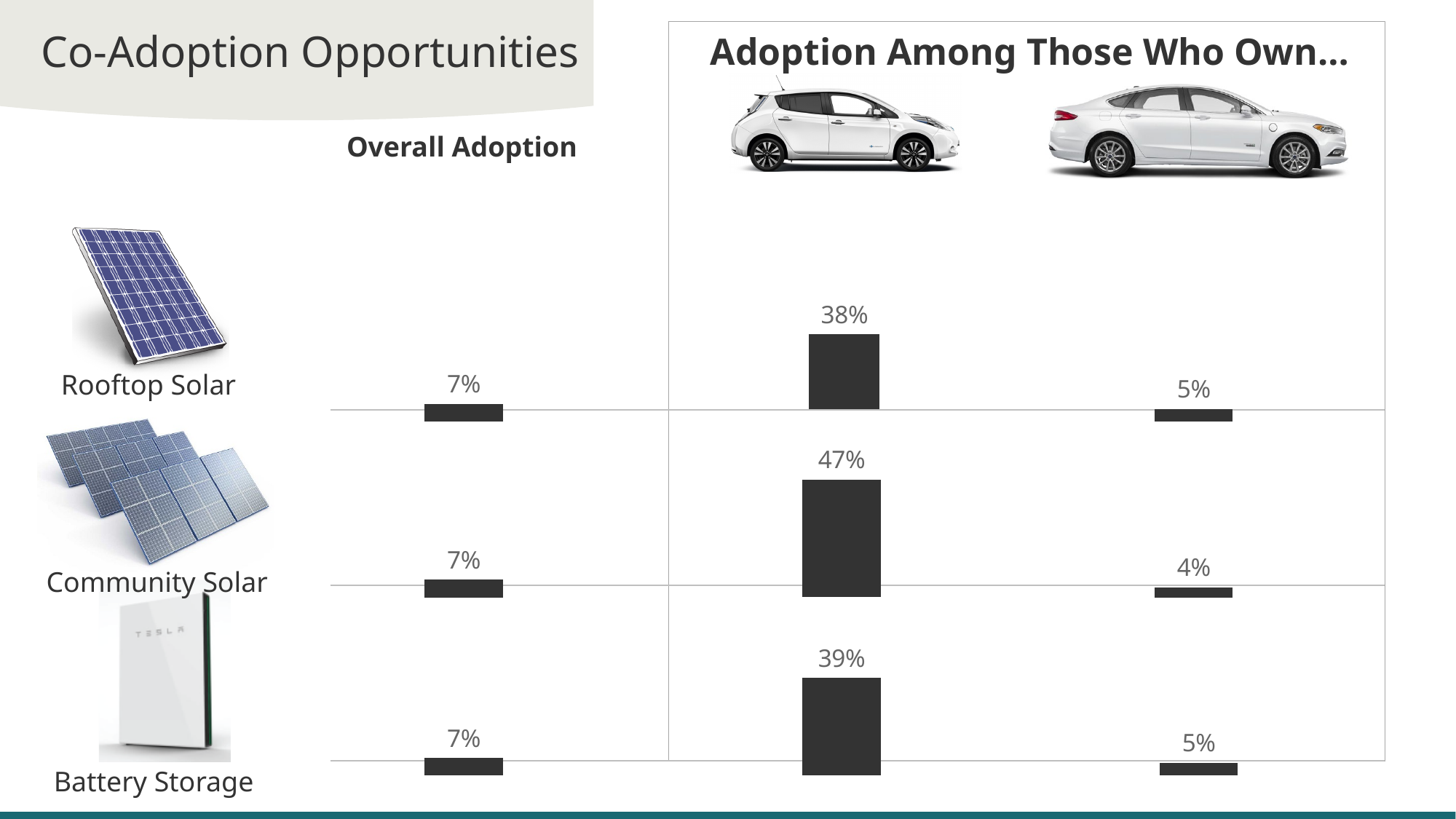
In the 'Adoption Among Those Who Own…' chart, what is the value for Battery Storage in the rightmost column (second car)? 5% In the middle column (first car) of the 'Adoption Among Those Who Own…' chart, which category has the highest value? Community Solar What kind of chart is used to show the adoption values? Bar chart In the middle column (first car), which is larger: the value for Rooftop Solar or for Battery Storage? Battery Storage What is the Overall Adoption value for Rooftop Solar? 7% How much higher is Community Solar adoption in the middle column (first car) than its Overall Adoption value? 40 percentage points What is the title of the chart on the right side of the slide? Adoption Among Those Who Own… In the rightmost column (second car) of the 'Adoption Among Those Who Own…' chart, which category has the lowest value? Community Solar How many product categories are shown in the charts? 3 For Rooftop Solar, what is the difference between the middle column (first car) value and the rightmost column (second car) value? 33 percentage points In the 'Adoption Among Those Who Own…' chart, what is the value for Community Solar in the middle column (first car)? 47% In the 'Adoption Among Those Who Own…' chart, what is the value for Community Solar in the rightmost column (second car)? 4%